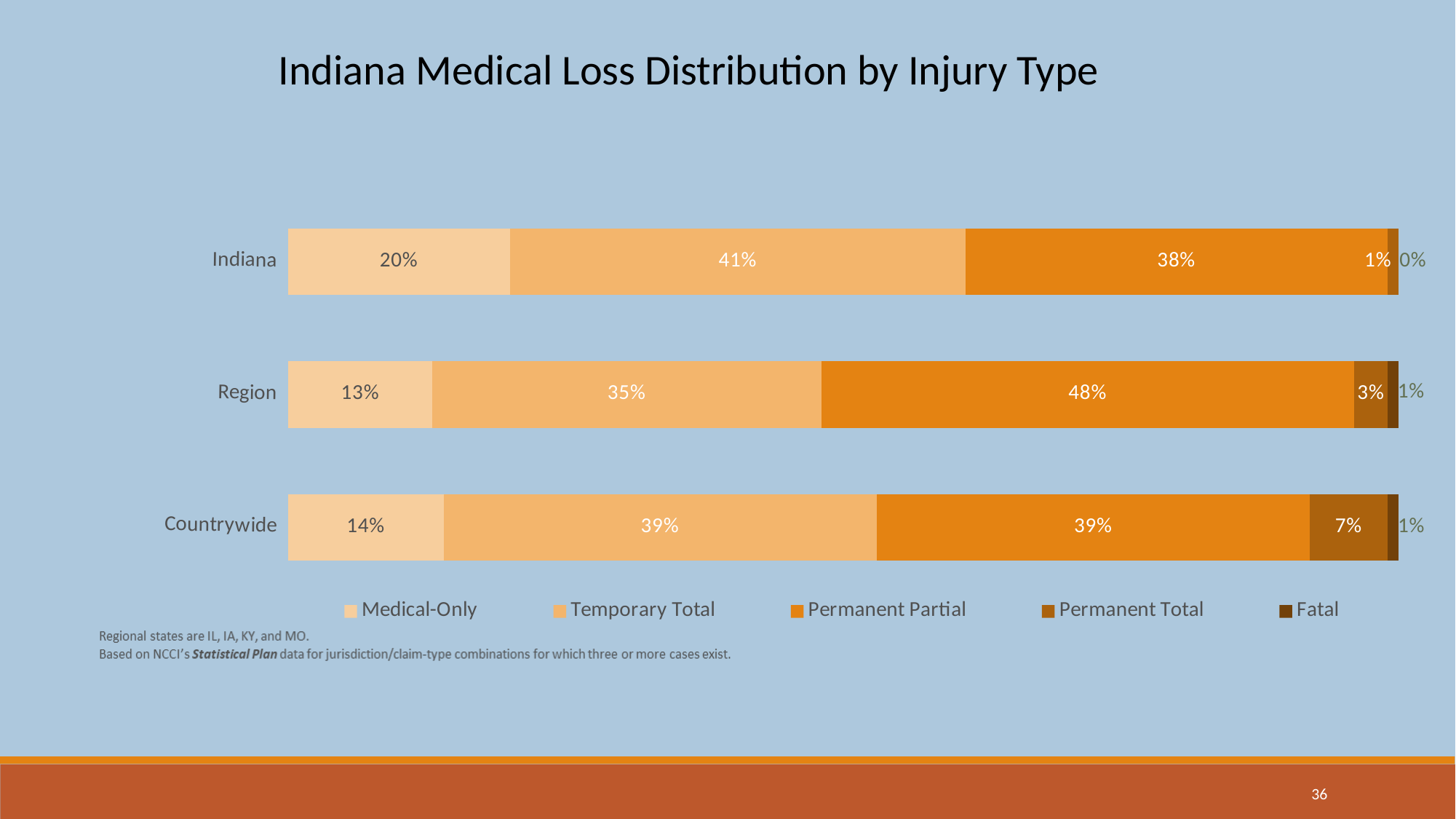
What is the Permanent Partial share for Region? 48% Which category has the lowest Permanent Partial share? Indiana What is the Medical-Only share for Region? 13% How many categories are shown on the chart? 3 What kind of chart is shown on the slide? Stacked bar chart What is the Temporary Total share for Indiana? 41% Which category has the highest Medical-Only share? Indiana How many series does the legend list? 5 What is the difference between the Permanent Partial shares for Region and Indiana? 10% What is the Permanent Total share for Countrywide? 7% Which is larger, the Temporary Total share for Indiana or for Region? Indiana What is the title of the chart? Indiana Medical Loss Distribution by Injury Type